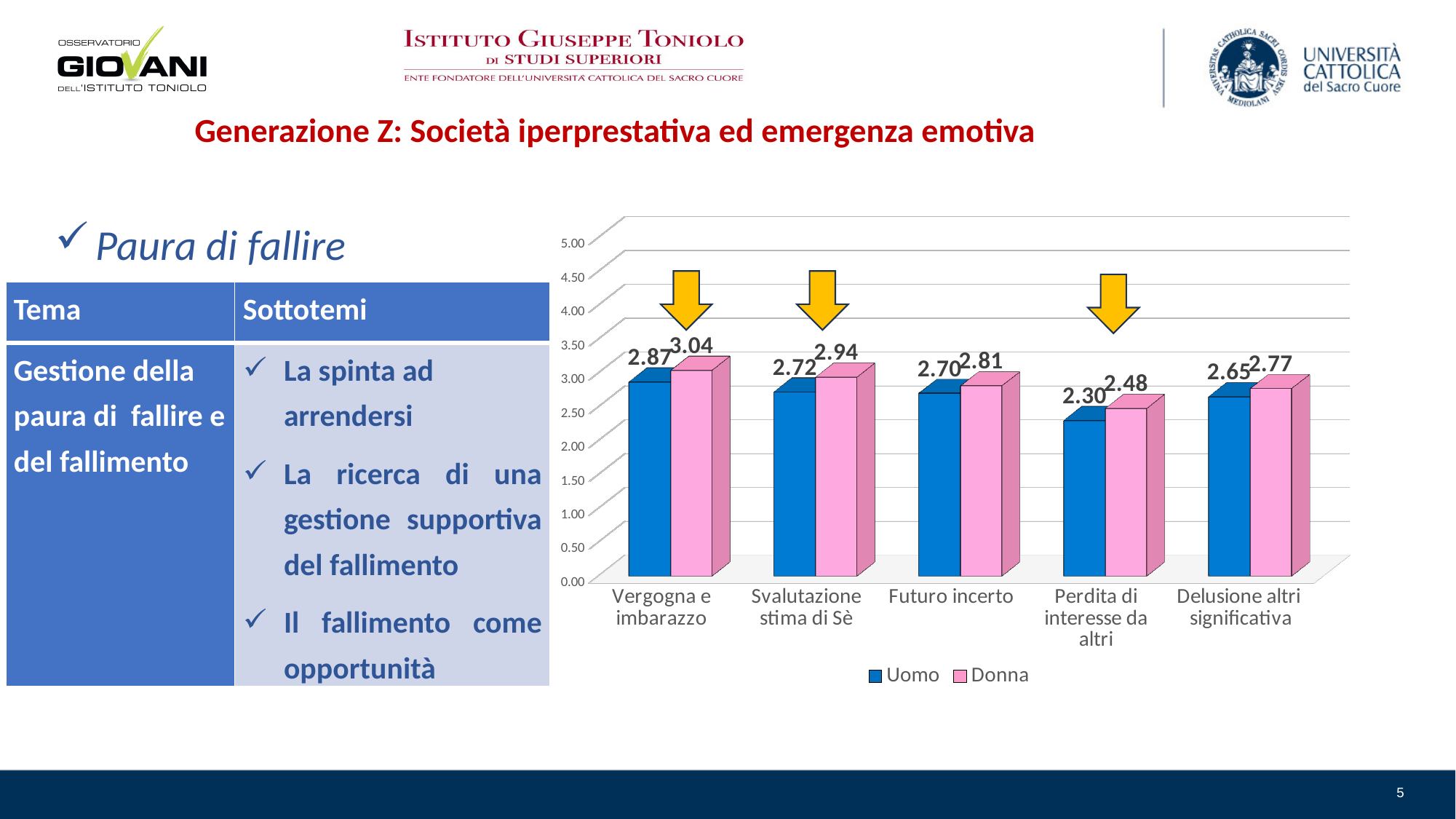
What is the difference between the Donna and Uomo values for Vergogna e imbarazzo? 0.17 Is the Donna value for Perdita di interesse da altri greater or less than 2.50? less How many series does the legend list? 2 What is the value for Uomo in the Vergogna e imbarazzo category? 2.87 Which category has the highest Donna value? Vergogna e imbarazzo What kind of chart is shown on the slide? Bar chart What is the value for Donna in the Perdita di interesse da altri category? 2.48 Which category has the lowest Uomo value? Perdita di interesse da altri Which is larger, the Uomo value for Delusione altri significativa or the Uomo value for Futuro incerto? Futuro incerto How many categories are shown on the x axis? 5 What is the difference between the Uomo values for Futuro incerto and Perdita di interesse da altri? 0.40 What is the value for Donna in the Svalutazione stima di Sè category? 2.94